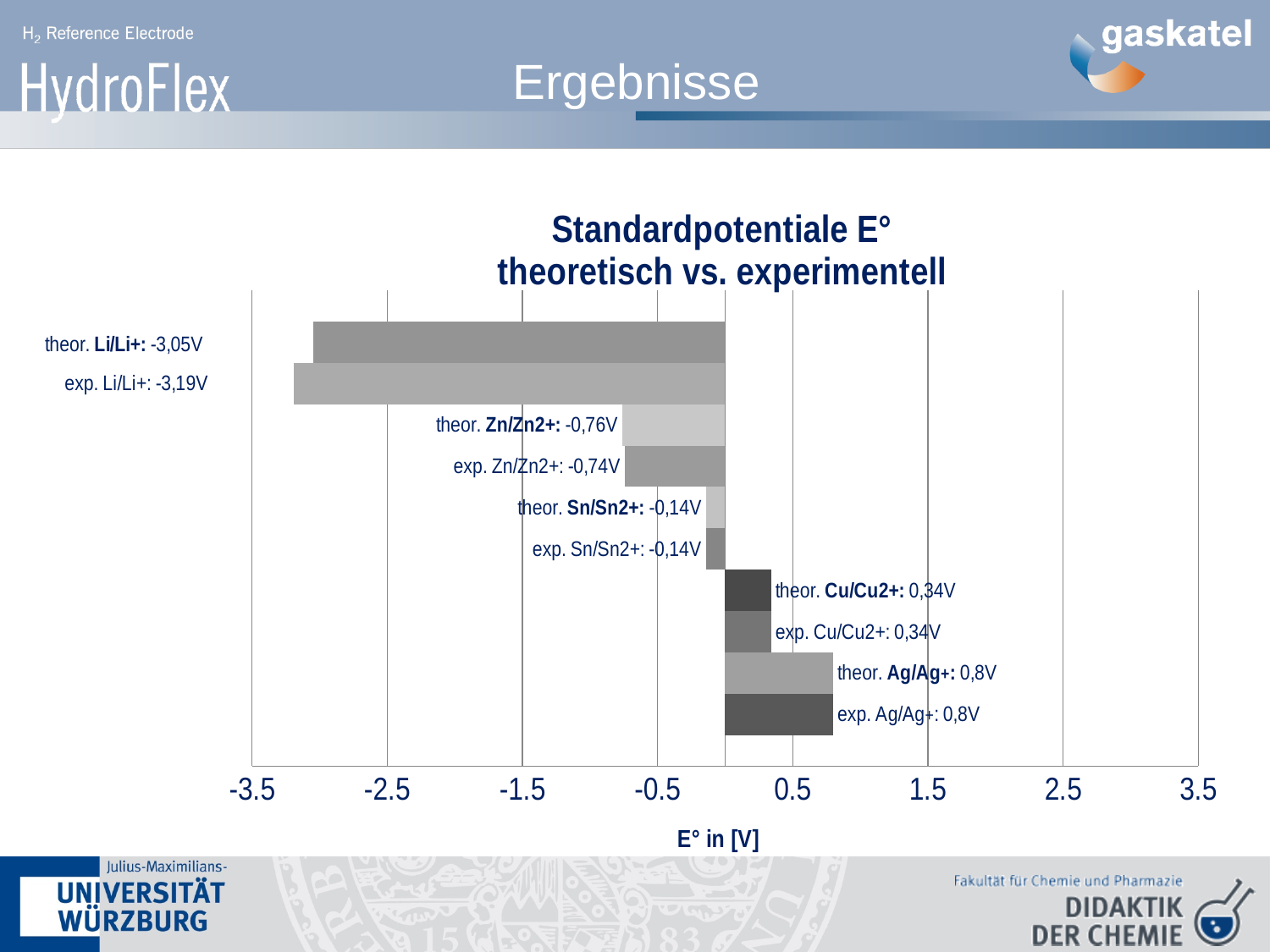
What kind of chart is shown on the slide? bar chart What is the value for exp. Cu/Cu2+? 0,34V What is the difference between the theor. Li/Li+ and exp. Li/Li+ values? 0,14V How many bars are plotted in the chart? 10 What is the value for theor. Li/Li+? -3,05V Which bar has the lowest value? exp. Li/Li+ What is the difference between the theor. Zn/Zn2+ and exp. Zn/Zn2+ values? 0,02V What is the value for exp. Ag/Ag+? 0,8V What is the value for exp. Li/Li+? -3,19V What is the title of the x axis? E° in [V] Which is larger, the value for theor. Zn/Zn2+ or exp. Zn/Zn2+? exp. Zn/Zn2+ What is the value for theor. Zn/Zn2+? -0,76V